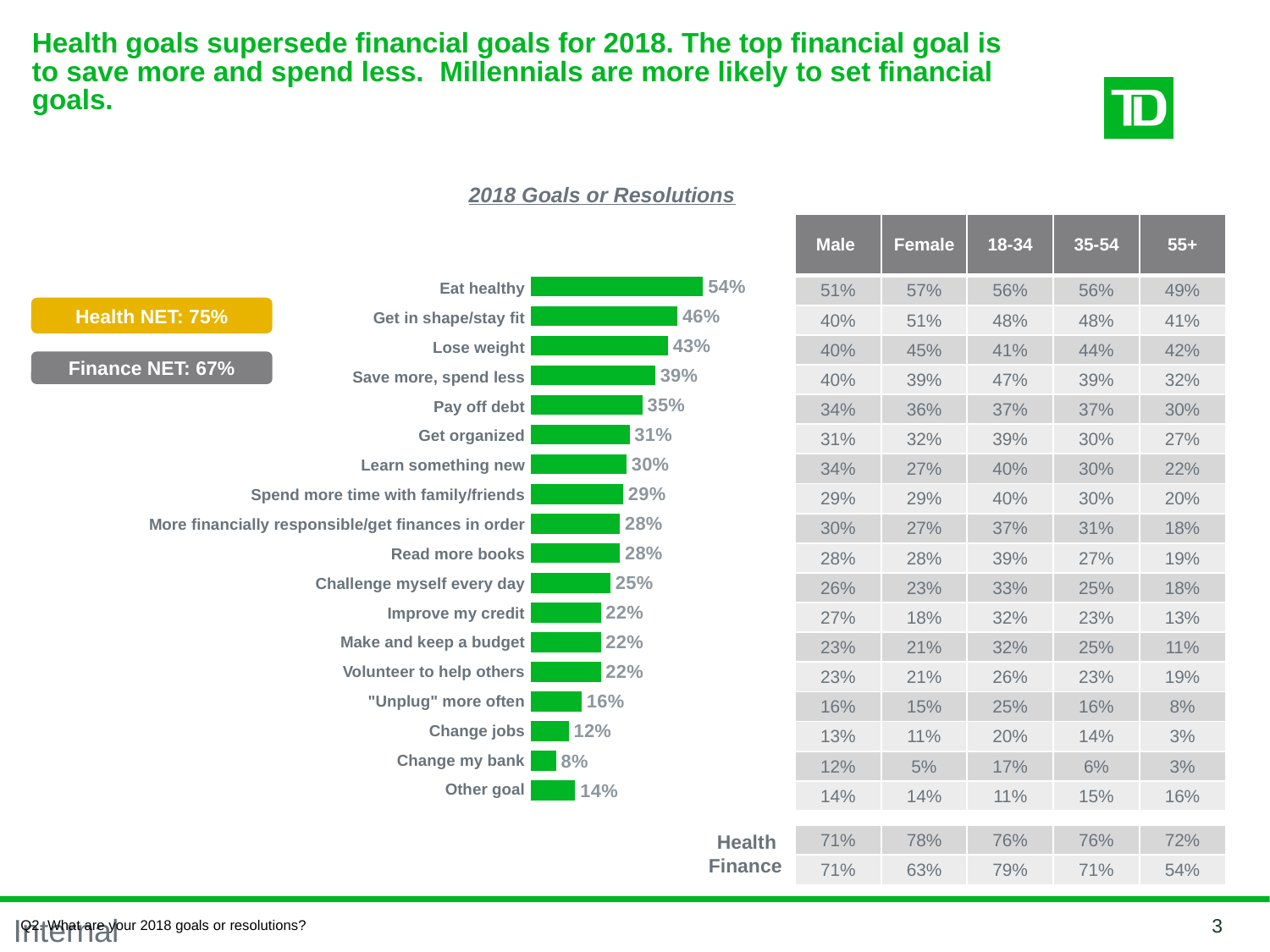
What percentage is shown for "Save more, spend less"? 39% What is the difference between "Eat healthy" and "Get in shape/stay fit"? 8% What is the value for "Other goal"? 14% What is the title of the chart? 2018 Goals or Resolutions What is the difference between "Pay off debt" and "Change jobs"? 23% Which is larger, "Lose weight" or "Get organized"? Lose weight What is the value for "Change my bank"? 8% Which goal has the highest percentage in the chart? Eat healthy What is the value for "Eat healthy" in the 2018 Goals or Resolutions chart? 54% How many goals are listed in the bar chart? 18 What type of chart is used to show the 2018 Goals or Resolutions? Bar chart Which goal has the lowest percentage in the chart? Change my bank